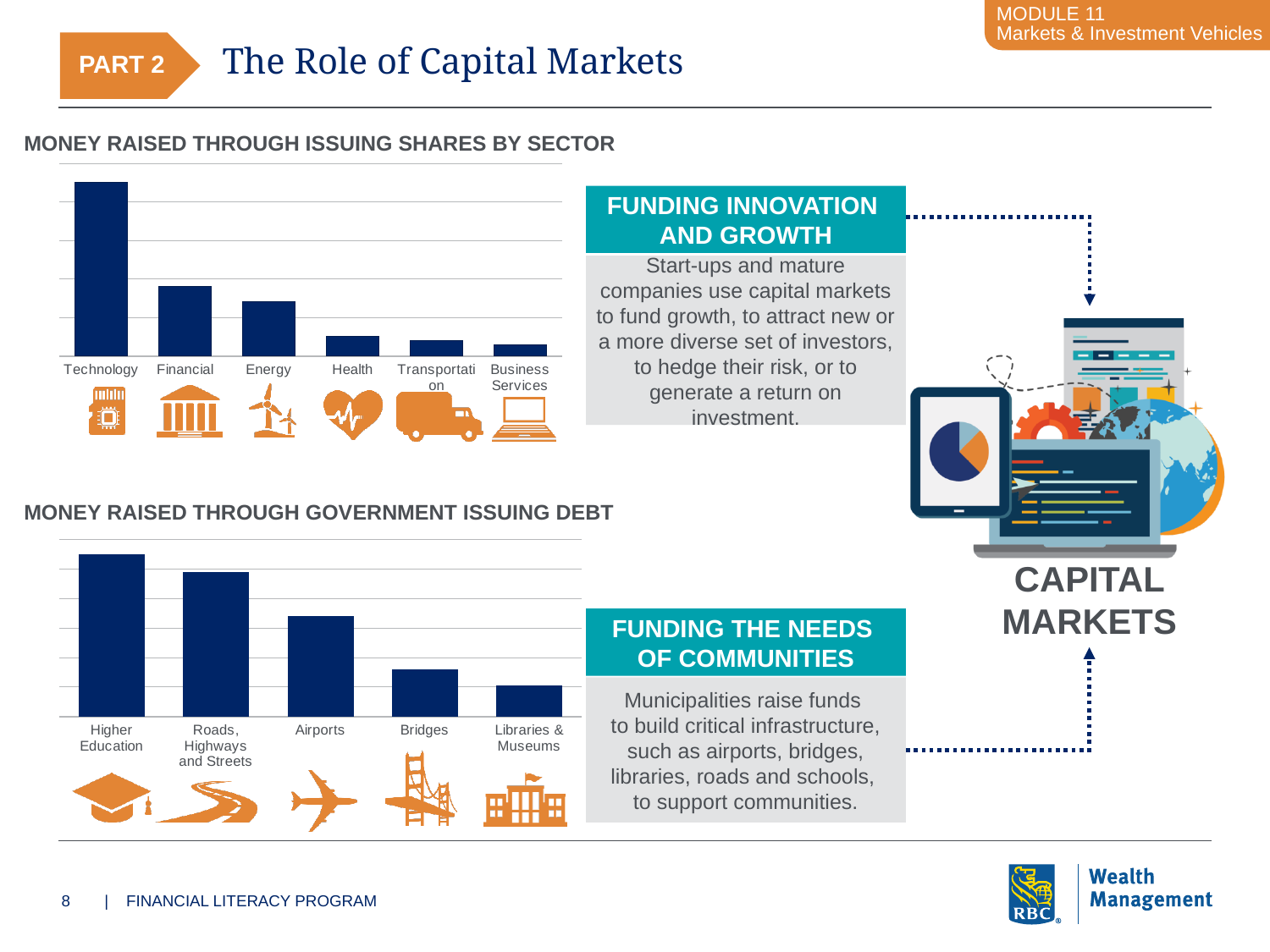
On the 'Money Raised Through Issuing Shares by Sector' chart, do the values rise or fall from left to right? fall On the 'Money Raised Through Issuing Shares by Sector' chart, which sector has the tallest bar? Technology What kind of chart is 'Money Raised Through Issuing Shares by Sector'? bar chart On the 'Money Raised Through Government Issuing Debt' chart, which is larger, Airports or Bridges? Airports On the 'Money Raised Through Government Issuing Debt' chart, do the values rise or fall from left to right? fall On the 'Money Raised Through Issuing Shares by Sector' chart, which is larger, Financial or Energy? Financial On the 'Money Raised Through Issuing Shares by Sector' chart, which is larger, Technology or Health? Technology On the 'Money Raised Through Government Issuing Debt' chart, how many categories are shown? 5 What is the title of the lower chart on the slide? Money Raised Through Government Issuing Debt On the 'Money Raised Through Government Issuing Debt' chart, which category has the shortest bar? Libraries & Museums On the 'Money Raised Through Issuing Shares by Sector' chart, how many sectors are shown? 6 On the 'Money Raised Through Government Issuing Debt' chart, which category has the tallest bar? Higher Education